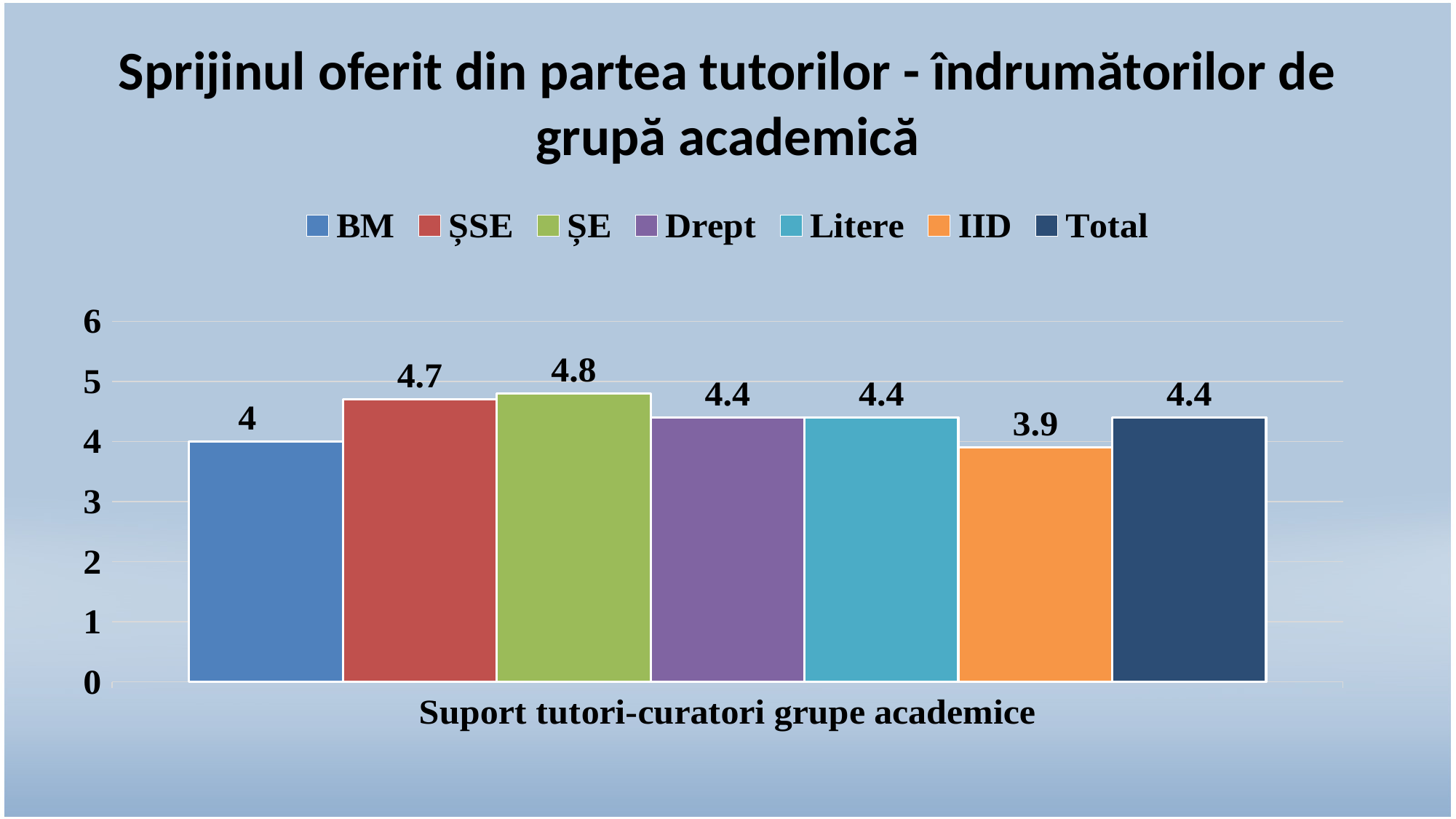
Which series has the lowest value? IID Which series has the highest value? ȘE What kind of chart is shown on the slide? Bar chart What is the value for Total? 4.4 What is the value for ȘSE? 4.7 Which is larger, the value for ȘSE or the value for Drept? ȘSE What is the label shown on the x axis below the bars? Suport tutori-curatori grupe academice What is the value for BM? 4 What is the difference between the values for ȘE and IID? 0.9 How many series does the legend list? 7 What is the value for IID? 3.9 What is the difference between the values for ȘSE and BM? 0.7